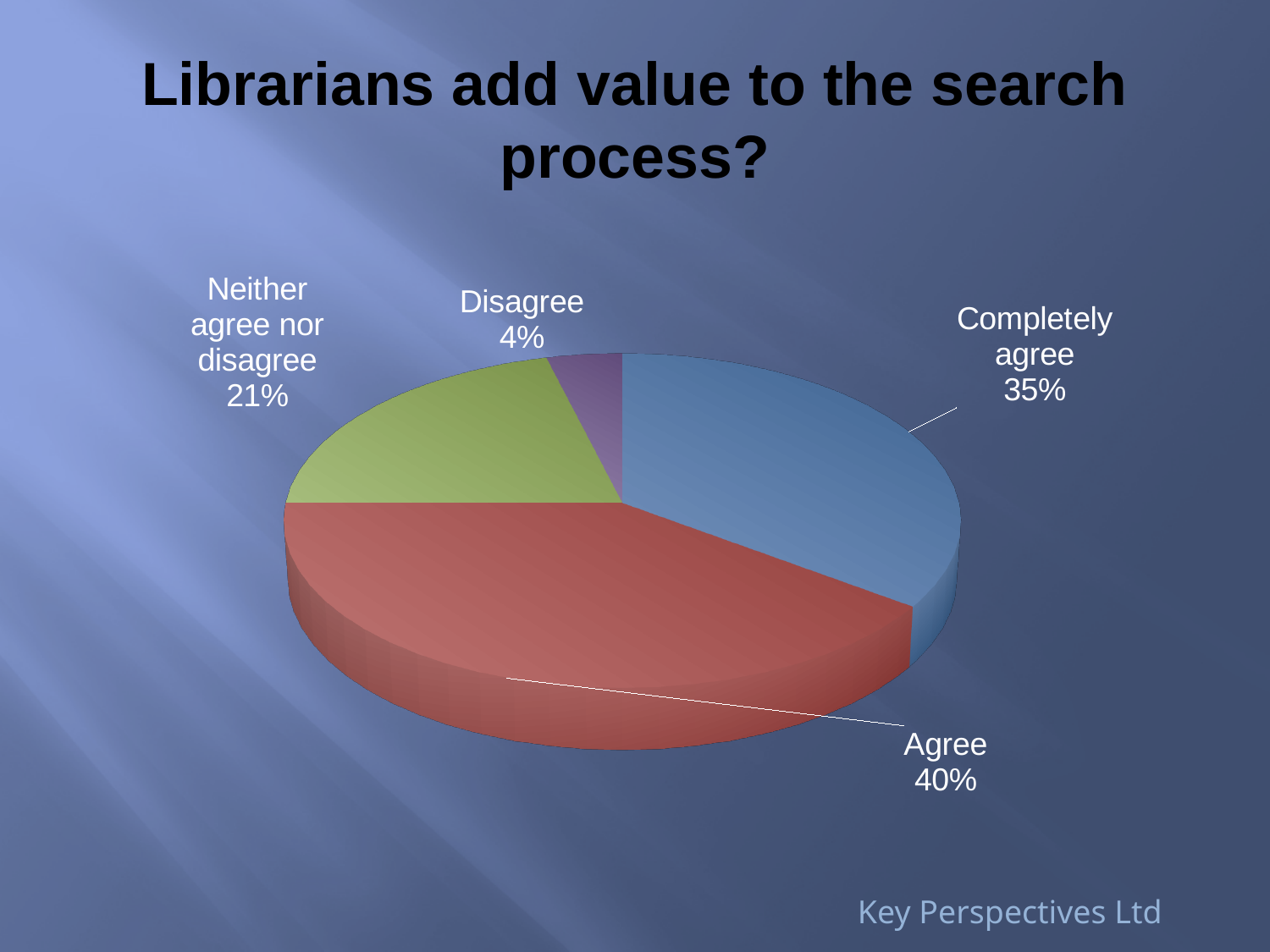
What kind of chart is shown on the slide? Pie chart What percentage of respondents chose "Completely agree"? 35% What percentage of respondents chose "Neither agree nor disagree"? 21% Which response has the largest share of the pie? Agree Which is larger, the share for "Neither agree nor disagree" or the share for "Disagree"? Neither agree nor disagree What percentage of respondents chose "Disagree"? 4% Which response has the smallest share of the pie? Disagree How many slices does the pie chart have? 4 What is the difference in percentage points between "Agree" and "Completely agree"? 5 What percentage of respondents chose "Agree"? 40% What is the title of the slide containing the chart? Librarians add value to the search process? What is the combined share of "Completely agree" and "Agree"? 75%